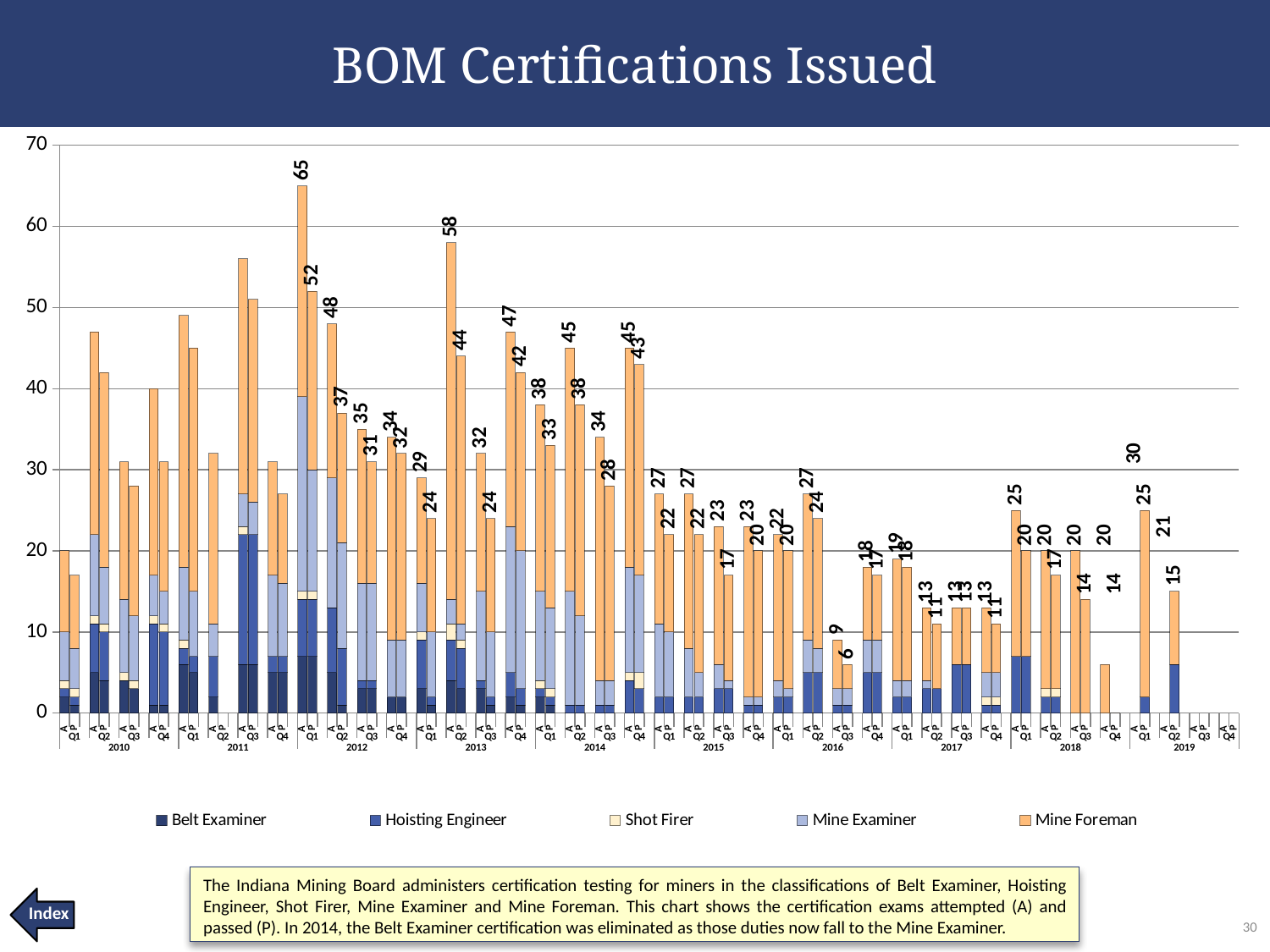
What is the total for the attempted (A) bar in 2015 Q3? 23 Is the attempted (A) total for 2010 Q2 greater or less than 40? greater What is the total for the passed (P) bar in 2013 Q4? 42 What is the difference between the attempted (A) and passed (P) totals in 2012 Q2? 11 Which series is shown in orange in the legend? Mine Foreman Which is larger, the attempted (A) total in 2012 Q2 or in 2012 Q4? 2012 Q2 How many years are shown along the x axis? 10 Which quarter has the highest attempted (A) total on the chart? 2012 Q1 What kind of chart is shown on the slide? Stacked bar chart How many series does the legend list? 5